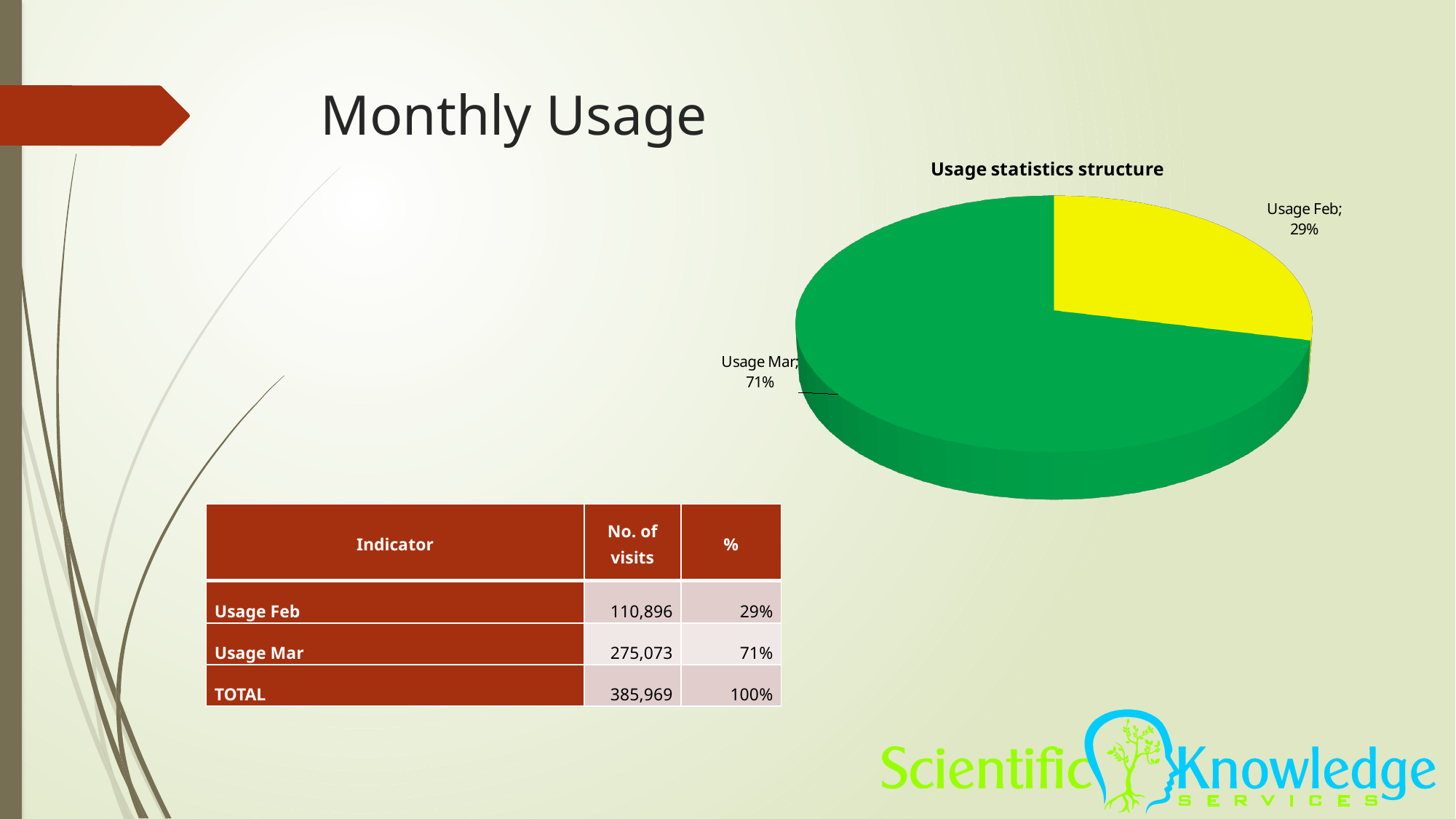
Is the share for Usage Mar greater or less than 50%? greater What share of the pie does Usage Feb represent? 29% What kind of chart is shown on the slide? pie chart What colour is the Usage Feb slice? yellow What is the difference in percentage points between the Usage Mar and Usage Feb slices? 42 What share of the pie does Usage Mar represent? 71% What is the title of the chart? Usage statistics structure Which slice of the pie is the smallest? Usage Feb Which is larger, the Usage Feb slice or the Usage Mar slice? Usage Mar Which slice of the pie is the largest? Usage Mar How many slices does the pie chart have? 2